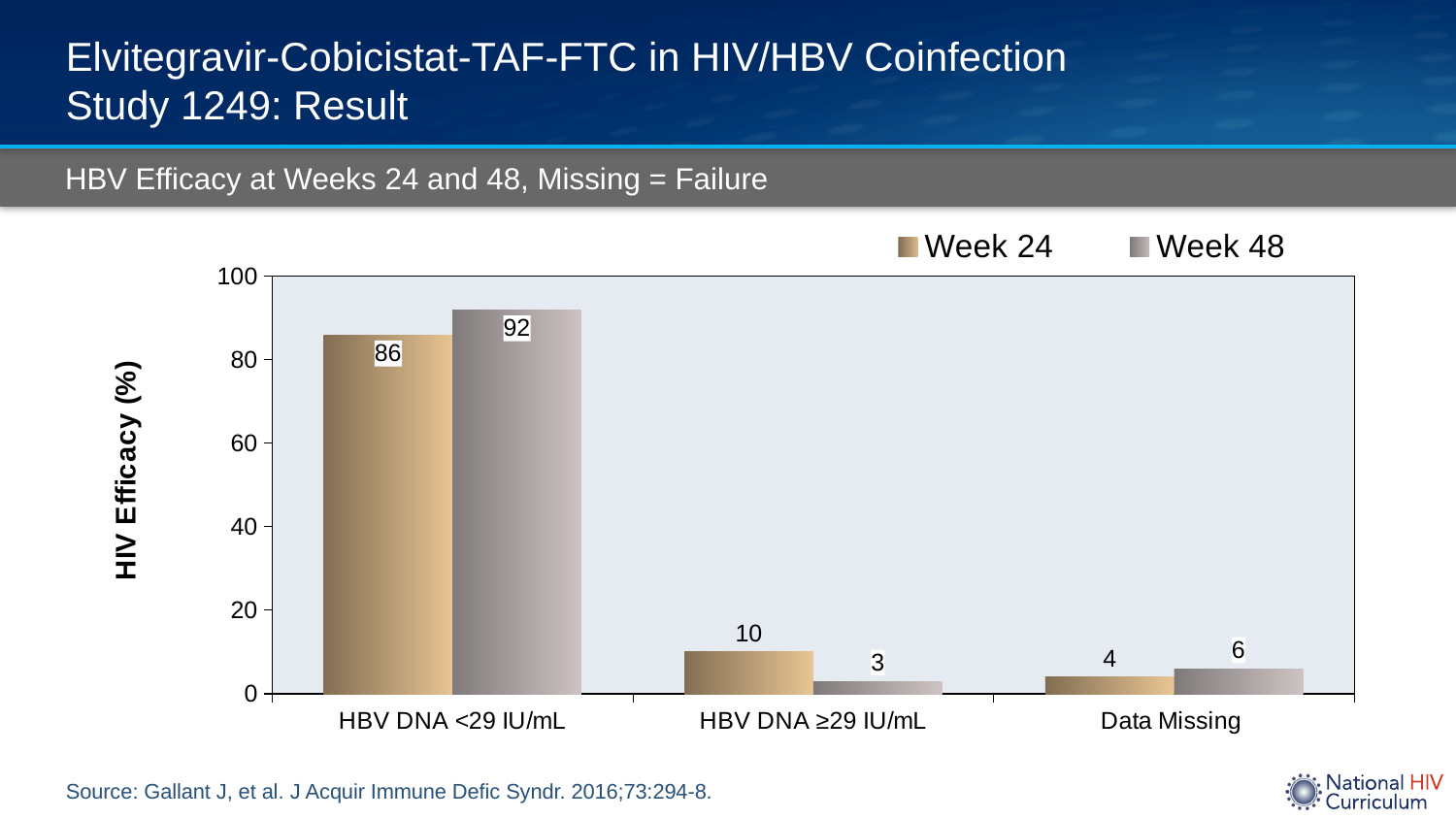
What is the Week 24 value for HBV DNA <29 IU/mL? 86 What kind of chart is shown on the slide? Bar chart Which category has the lowest Week 48 value? HBV DNA ≥29 IU/mL What is the Week 48 value for Data Missing? 6 How many series does the legend list? 2 What is the difference between the Week 48 and Week 24 values for HBV DNA <29 IU/mL? 6 What is the Week 24 value for HBV DNA ≥29 IU/mL? 10 For HBV DNA ≥29 IU/mL, which is larger: the Week 24 value or the Week 48 value? Week 24 What is the Week 48 value for HBV DNA <29 IU/mL? 92 How many categories are shown on the x axis? 3 Is the Week 24 value for HBV DNA <29 IU/mL greater or less than 80? greater Which category has the highest Week 48 value? HBV DNA <29 IU/mL